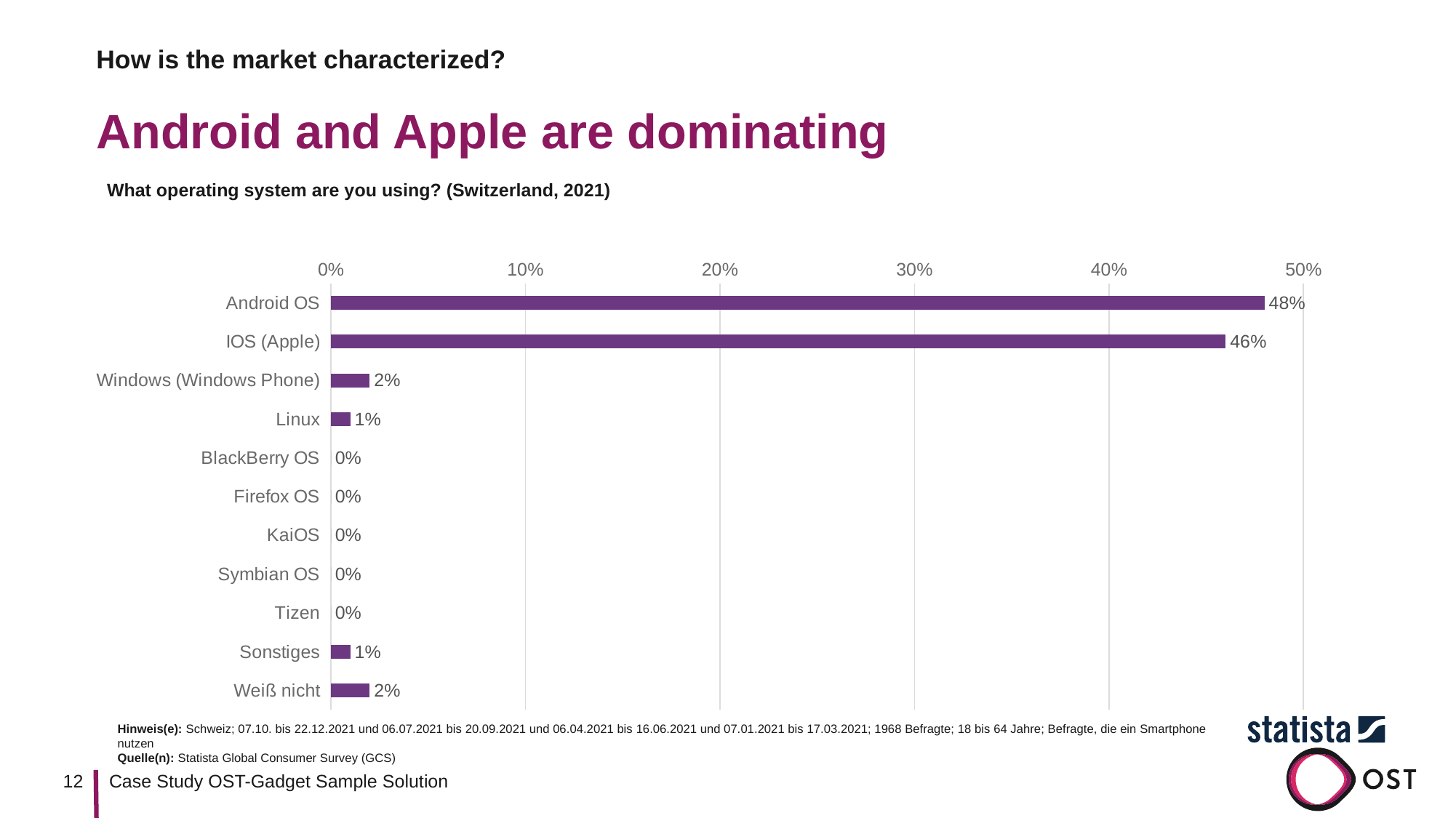
Which is larger, the value for Windows (Windows Phone) or the value for Linux? Windows (Windows Phone) Is the value for IOS (Apple) greater or less than 40%? greater How many operating system categories are shown in the chart? 11 What is the value for Android OS? 48% What is the value for Windows (Windows Phone)? 2% What is the value for Linux? 1% What is the value for Weiß nicht? 2% What kind of chart is shown on the slide? bar chart What is the value for IOS (Apple)? 46% What is the difference between the values for Android OS and IOS (Apple)? 2% What is the title of the chart? What operating system are you using? (Switzerland, 2021) Which operating system has the highest value? Android OS